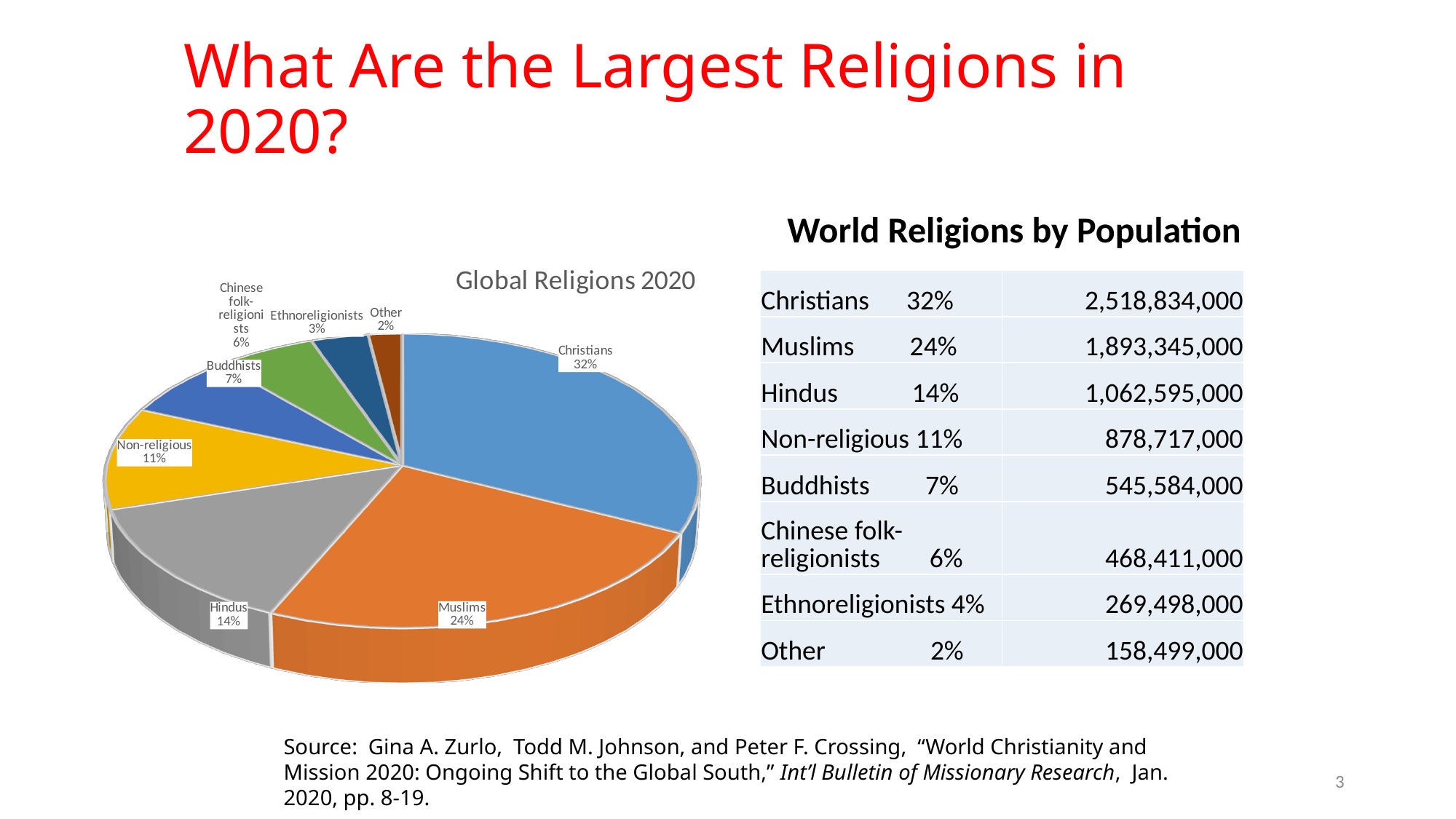
In the "Global Religions 2020" pie chart, what share is shown for Muslims? 24% In the "Global Religions 2020" pie chart, what share is shown for Christians? 32% In the "Global Religions 2020" pie chart, what share is shown for Buddhists? 7% In the "Global Religions 2020" pie chart, how many percentage points larger is the Christians slice than the Muslims slice? 8 In the "Global Religions 2020" pie chart, which category has the smallest slice? Other What is the title of the pie chart on the slide? Global Religions 2020 How many slices does the "Global Religions 2020" pie chart have? 8 In the "Global Religions 2020" pie chart, which category has the largest slice? Christians In the "Global Religions 2020" pie chart, which slice is larger, Hindus or Non-religious? Hindus What kind of chart is the "Global Religions 2020" chart? pie chart In the "Global Religions 2020" pie chart, what share is shown for Non-religious? 11% In the "Global Religions 2020" pie chart, what share is shown for Hindus? 14%